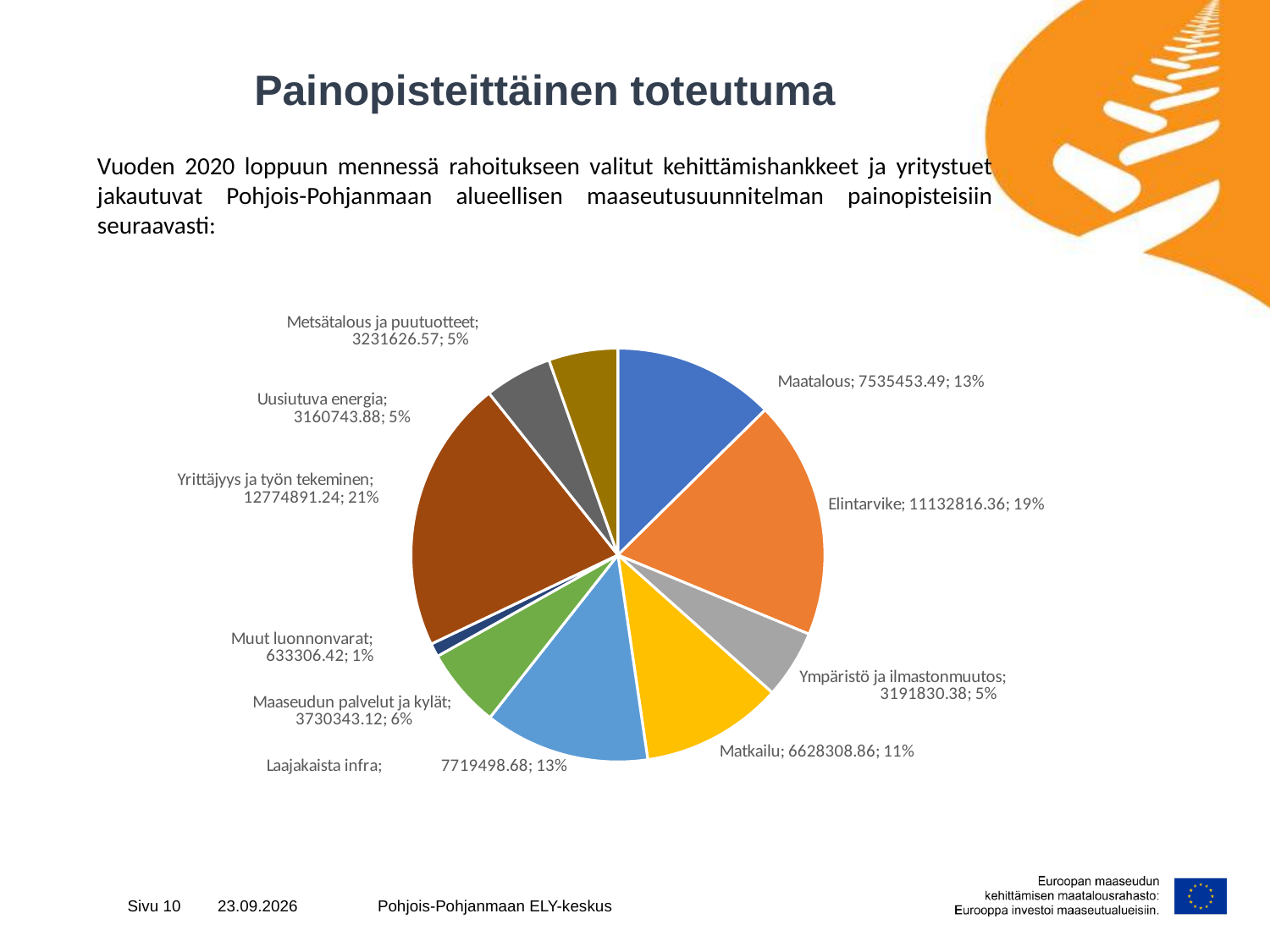
What share of the pie does Ympäristö ja ilmastonmuutos represent? 5% What share of the pie does Maaseudun palvelut ja kylät represent? 6% Which category has the largest slice of the pie? Yrittäjyys ja työn tekeminen How many slices does the pie chart have? 10 What share of the pie does Yrittäjyys ja työn tekeminen represent? 21% What is the value for Muut luonnonvarat? 633306.42 What is the value for Elintarvike? 11132816.36 What is the value for Matkailu? 6628308.86 Which is larger, the value for Elintarvike or the value for Maatalous? Elintarvike What is the difference between the values for Laajakaista infra and Maatalous? 184045.19 Which category has the smallest slice of the pie? Muut luonnonvarat What kind of chart is shown on the slide? pie chart